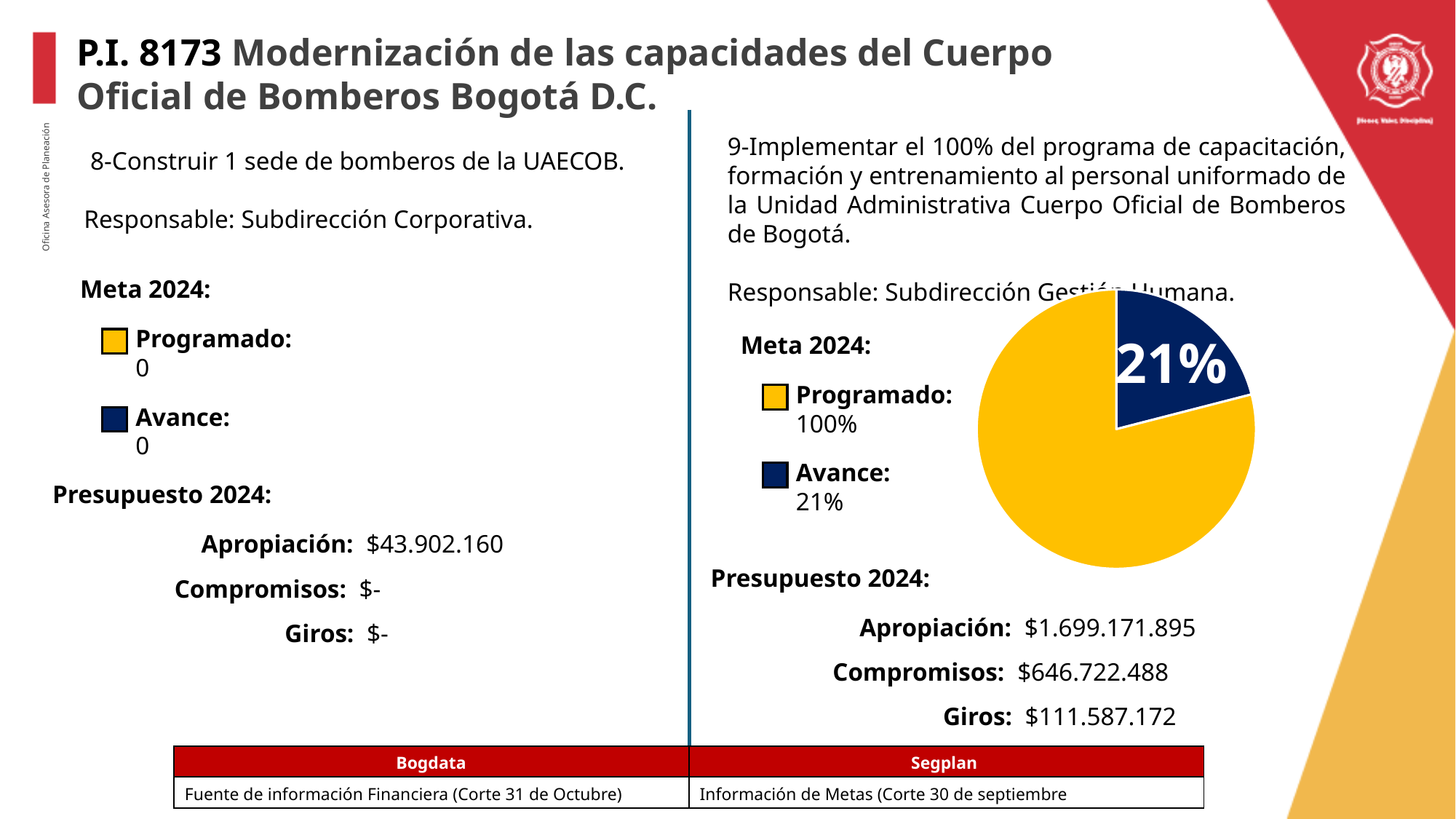
Which colour in the pie chart legend corresponds to 'Programado'? yellow In the pie chart, which slice is larger, the yellow one or the dark blue one? the yellow one What colour is the slice labelled 21% in the pie chart? dark blue How many slices does the pie chart on the slide have? 2 In the pie chart, which slice is the smallest? the dark blue slice (Avance, 21%) According to the legend next to the pie chart, what is the 'Avance' value for Meta 2024 of goal 9? 21% Is the dark blue slice of the pie chart less than or greater than half of the pie? less In the pie chart, what value does the dark blue slice represent (Avance)? 21% According to the legend next to the pie chart, what is the 'Programado' value for Meta 2024 of goal 9? 100% What kind of chart is shown on the right side of the slide, next to 'Meta 2024' for goal 9? pie chart What percentage is printed on the pie chart on the slide? 21%